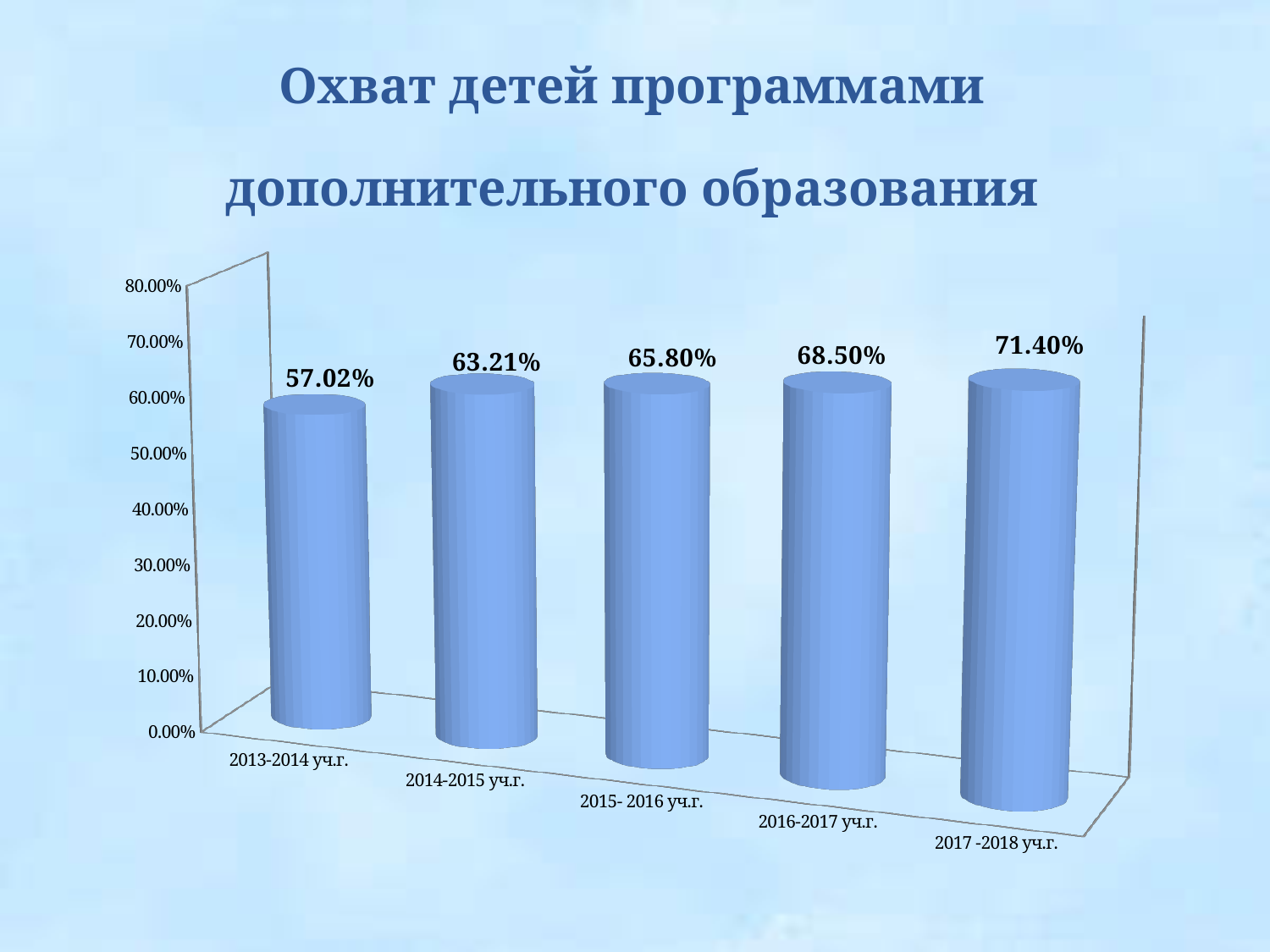
What is the value for 2013-2014 уч.г.? 57.02% What is the value for 2015- 2016 уч.г.? 65.80% Which is larger, the value for 2014-2015 уч.г. or the value for 2016-2017 уч.г.? 2016-2017 уч.г. What is the value for 2017 -2018 уч.г.? 71.40% How many school years are shown on the chart? 5 Do the values rise or fall from 2013-2014 уч.г. to 2017 -2018 уч.г.? rise What is the difference between the values for 2017 -2018 уч.г. and 2013-2014 уч.г.? 14.38% Which school year has the highest value? 2017 -2018 уч.г. Which school year has the lowest value? 2013-2014 уч.г. What is the difference between the values for 2016-2017 уч.г. and 2015- 2016 уч.г.? 2.70% What kind of chart is shown on the slide? bar chart Is the value for 2014-2015 уч.г. greater or less than 60.00%? greater